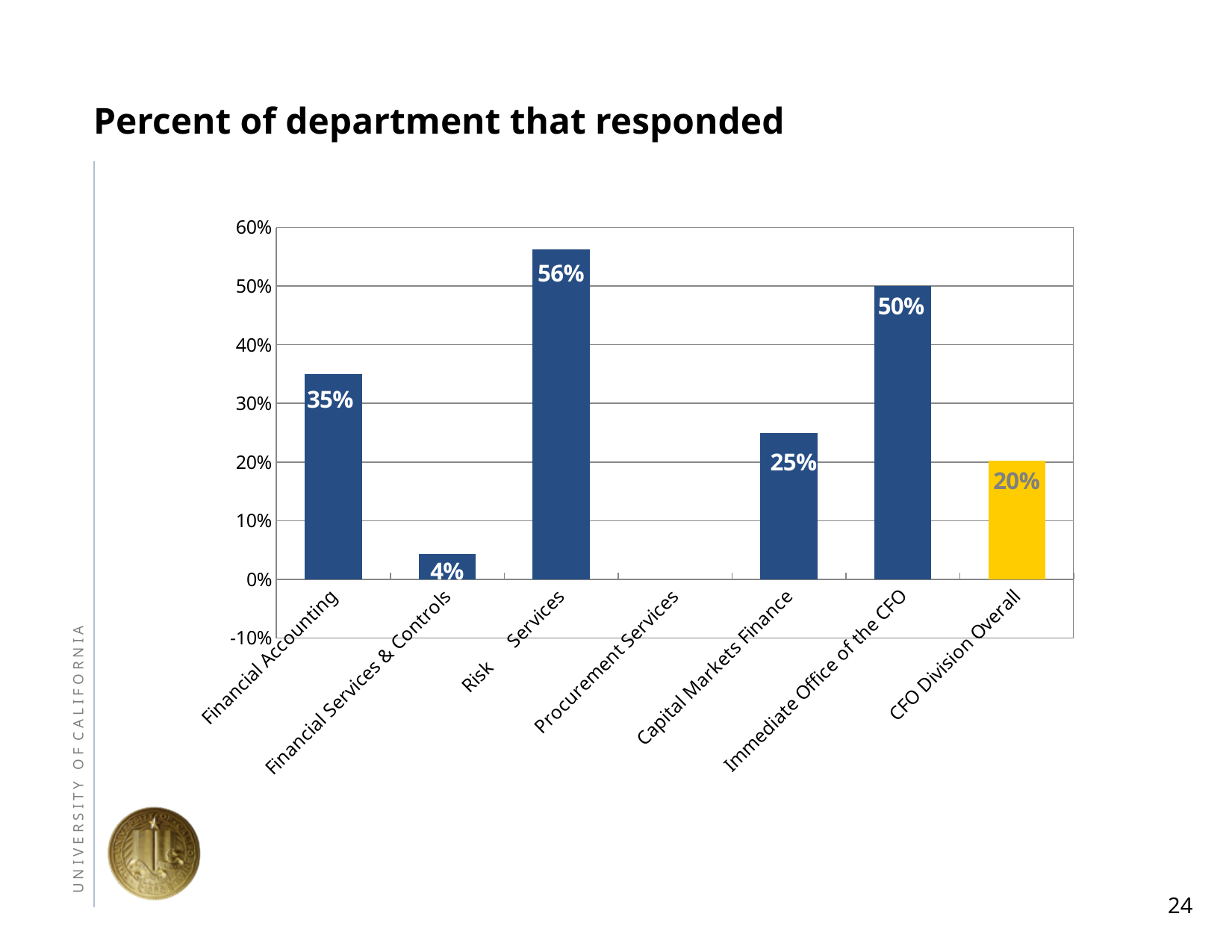
What is the difference between the values for Risk Services and Immediate Office of the CFO? 6% What is the value shown for CFO Division Overall? 20% Which department has the highest response percentage? Risk Services How many categories are shown on the x axis of the chart? 7 What is the value shown for Risk Services? 56% What is the difference between the values for Financial Accounting and Capital Markets Finance? 10% Which is larger, the value for Capital Markets Finance or the value for CFO Division Overall? Capital Markets Finance What percent of Financial Accounting responded? 35% What is the value shown for Immediate Office of the CFO? 50% Which bar is coloured yellow rather than blue? CFO Division Overall What kind of chart is shown on the slide? Bar chart What is the value shown for Financial Services & Controls? 4%